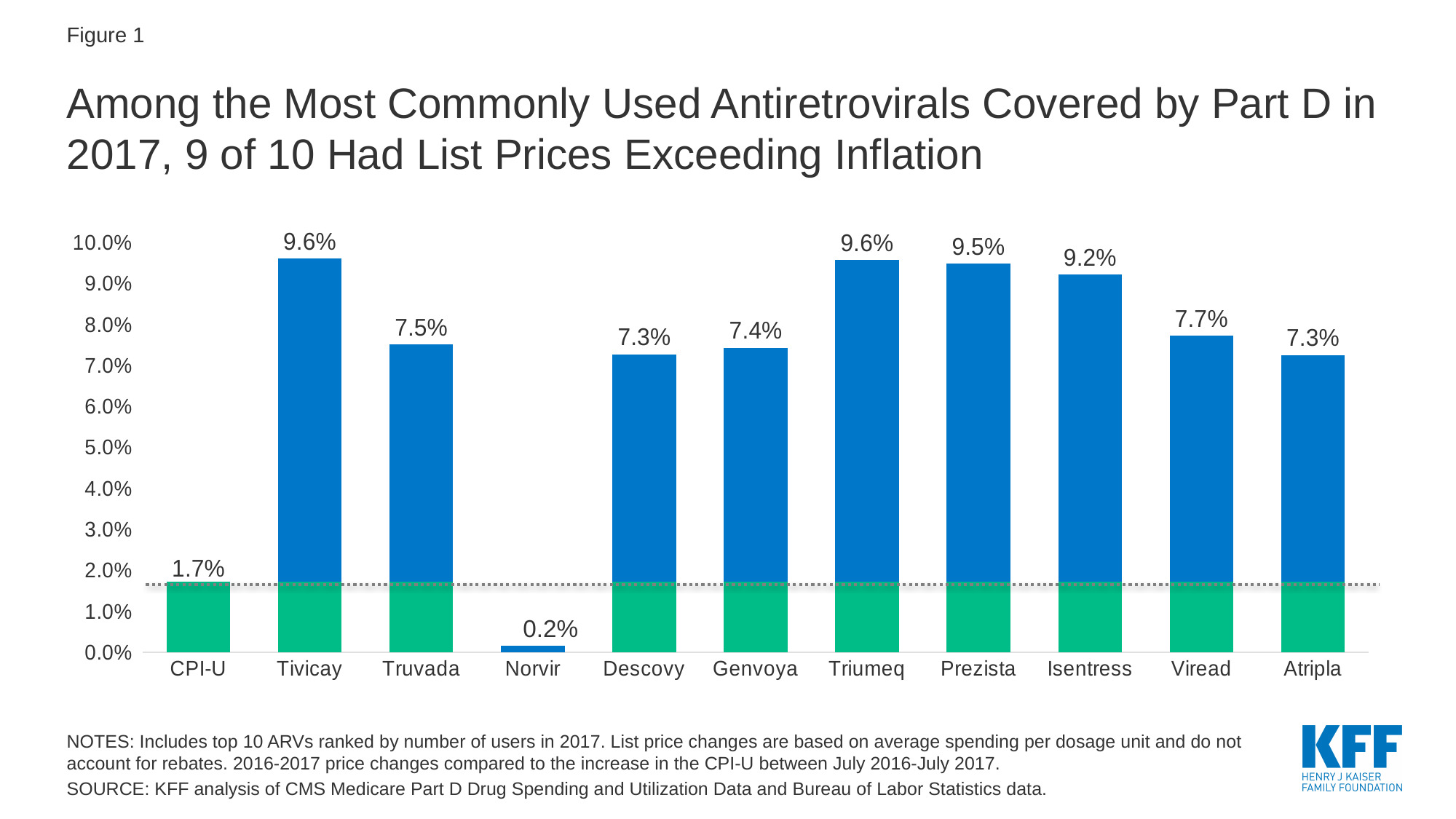
How many categories are shown on the x axis? 11 Which category has the lowest value? Norvir Which is larger, the value for Genvoya or the value for Descovy? Genvoya What is the difference between the values for Prezista and Truvada? 2.0% What kind of chart is shown on the slide? Bar chart What is the value shown for Isentress? 9.2% What is the value shown for Atripla? 7.3% What is the value shown for Norvir? 0.2% Which is larger, the value for Isentress or the value for Viread? Isentress What is the difference between the values for Viread and CPI-U? 6.0% What is the value shown for Tivicay? 9.6% What is the value shown for CPI-U? 1.7%